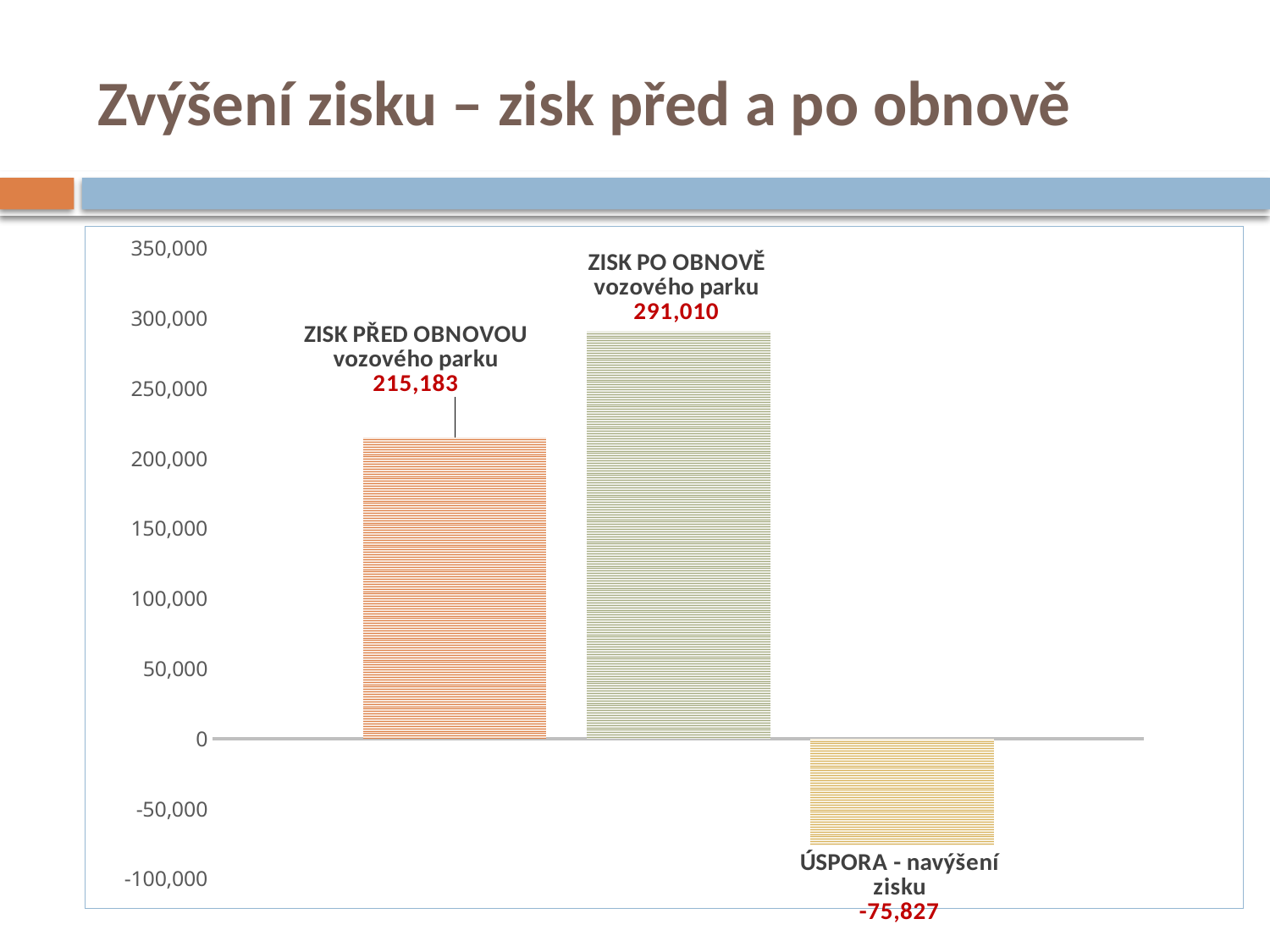
What is the difference between ZISK PO OBNOVĚ vozového parku and ZISK PŘED OBNOVOU vozového parku? 75,827 Which category has the lowest value? ÚSPORA - navýšení zisku What kind of chart is shown on the slide? bar chart What is the value for ZISK PŘED OBNOVOU vozového parku? 215,183 What is the title of the slide containing the chart? Zvýšení zisku – zisk před a po obnově Which is larger, ZISK PŘED OBNOVOU vozového parku or ZISK PO OBNOVĚ vozového parku? ZISK PO OBNOVĚ vozového parku Which category has the highest value? ZISK PO OBNOVĚ vozového parku Is the value for ZISK PO OBNOVĚ vozového parku greater or less than 250,000? greater How many bars are plotted in the chart? 3 Is the value for ZISK PŘED OBNOVOU vozového parku greater or less than 250,000? less What is the value for ZISK PO OBNOVĚ vozového parku? 291,010 What is the value for ÚSPORA - navýšení zisku? -75,827